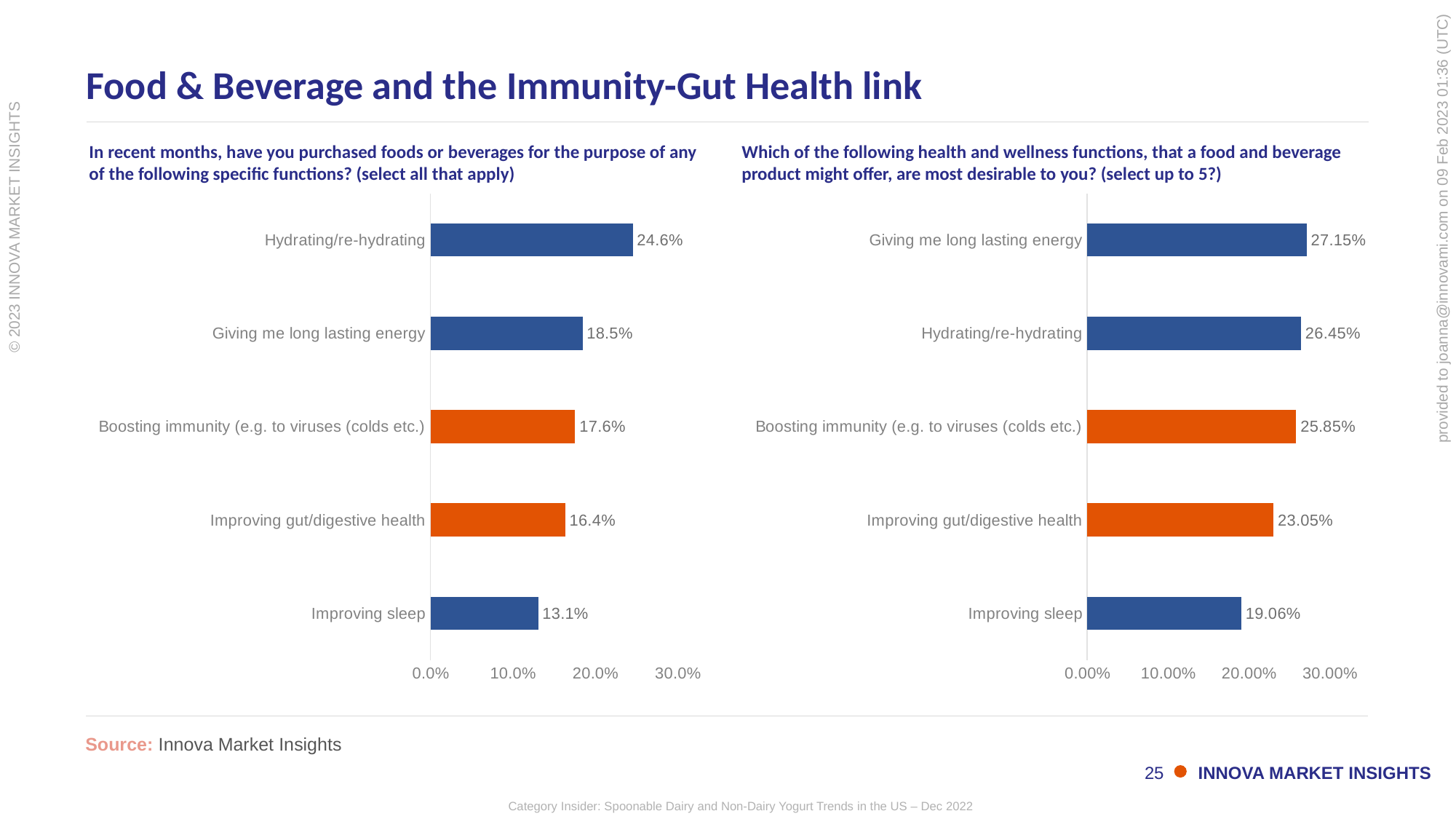
How many categories are shown in the left chart (purchased foods or beverages for specific functions)? 5 In the right chart (most desirable health and wellness functions), what is the difference between Giving me long lasting energy and Boosting immunity (e.g. to viruses (colds etc.)? 1.30% In the right chart (most desirable health and wellness functions), which categories are shown with orange bars? Boosting immunity (e.g. to viruses (colds etc.) and Improving gut/digestive health In the right chart (most desirable health and wellness functions), what is the value for Improving gut/digestive health? 23.05% What type of chart is the right chart (most desirable health and wellness functions)? Bar chart In the left chart (purchased foods or beverages for specific functions), which is larger: Boosting immunity or Improving gut/digestive health? Boosting immunity In the left chart (purchased foods or beverages for specific functions), what is the difference between Hydrating/re-hydrating and Improving sleep? 11.5% In the left chart (purchased foods or beverages for specific functions), what is the value for Hydrating/re-hydrating? 24.6% In the right chart (most desirable health and wellness functions), is the value for Improving sleep greater or less than 20.00%? less In the right chart (most desirable health and wellness functions), which category has the lowest value? Improving sleep In the left chart (purchased foods or beverages for specific functions), which category has the highest value? Hydrating/re-hydrating In the left chart (purchased foods or beverages for specific functions), what is the value for Giving me long lasting energy? 18.5%